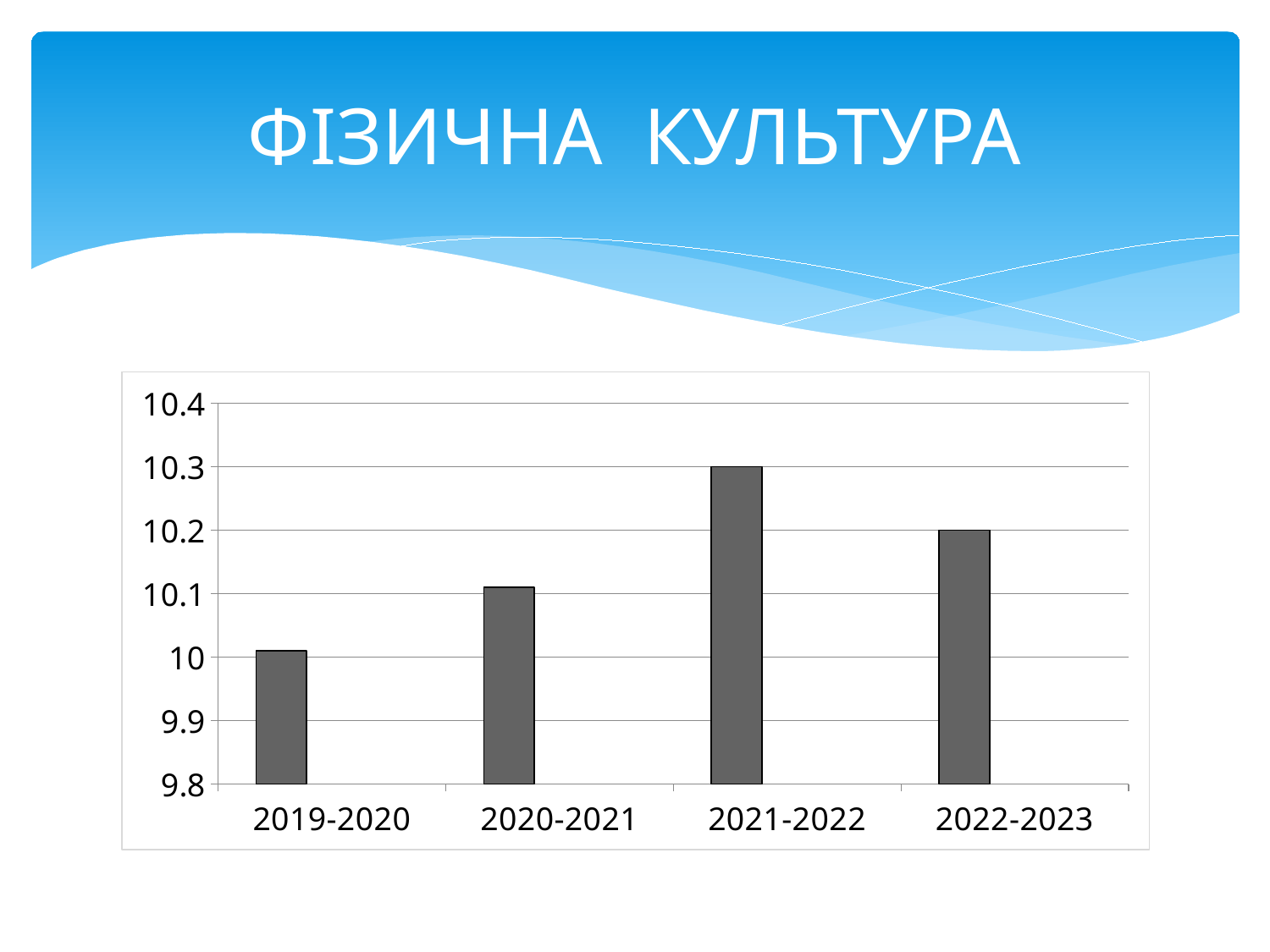
What is the value for 2021-2022? 10.3 Which is larger, the value for 2021-2022 or the value for 2022-2023? 2021-2022 Which school year has the lowest value? 2019-2020 Is the value for 2019-2020 greater or less than 9.9? greater Is the value for 2019-2020 greater or less than 10.1? less What is the value for 2022-2023? 10.2 What kind of chart is shown on the slide? bar chart What is the title shown at the top of the slide? ФІЗИЧНА КУЛЬТУРА Do the values rise or fall from 2019-2020 to 2021-2022? rise Which school year has the highest value? 2021-2022 Is the value for 2020-2021 greater or less than 10? greater How many categories (school years) are shown on the x axis? 4